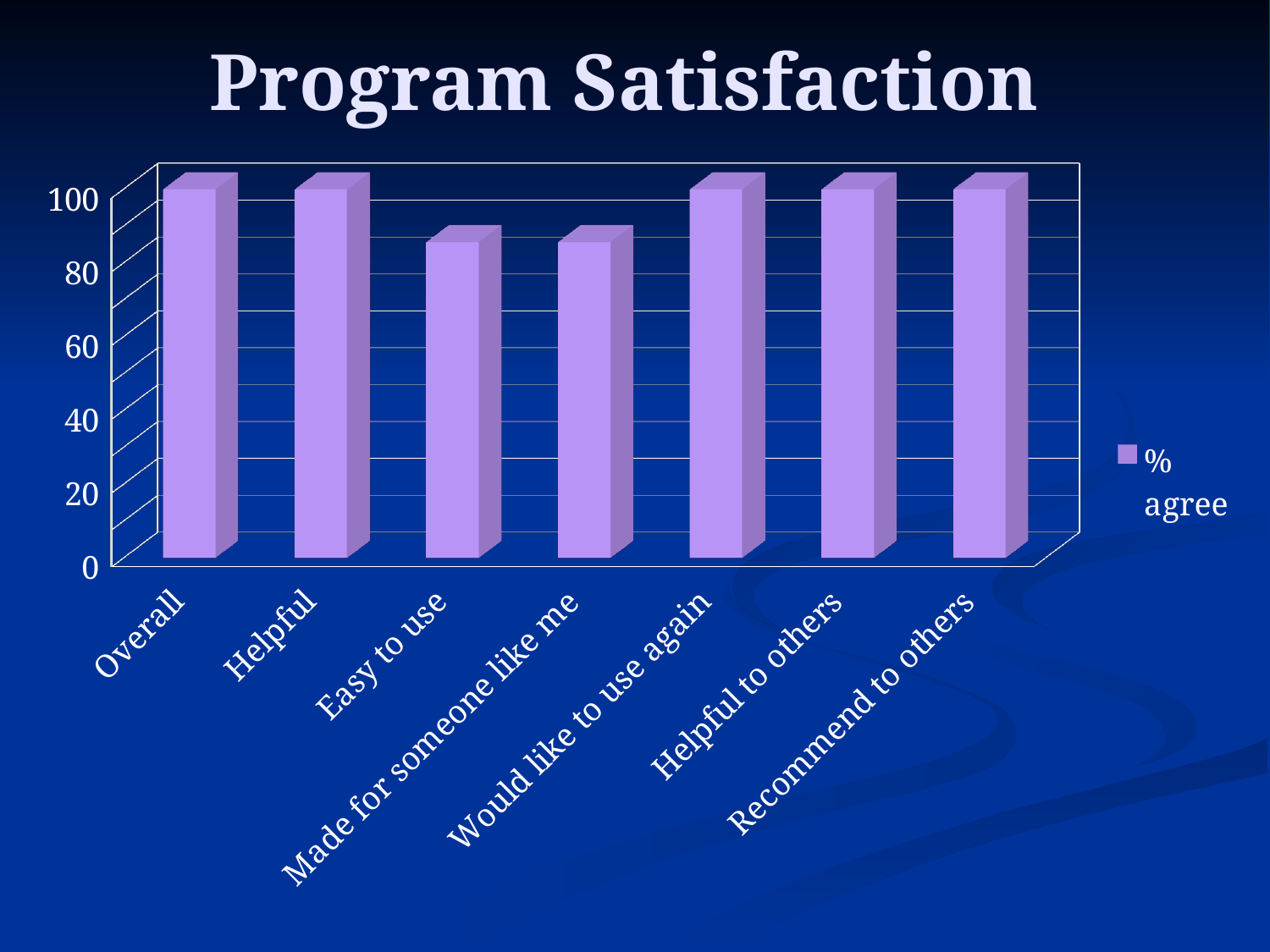
How many series does the legend list? 1 Is the value for Helpful greater or less than 80? greater How many categories are shown on the x axis of the chart? 7 Is the value for Would like to use again greater or less than 90? greater What series name is shown in the legend? % agree What is the value for Overall? 100 Which is larger, the value for Overall or the value for Easy to use? Overall Is the value for Easy to use greater or less than 80? greater Which is larger, the value for Made for someone like me or the value for Recommend to others? Recommend to others What kind of chart is shown on the slide? bar chart What is the title of the chart? Program Satisfaction